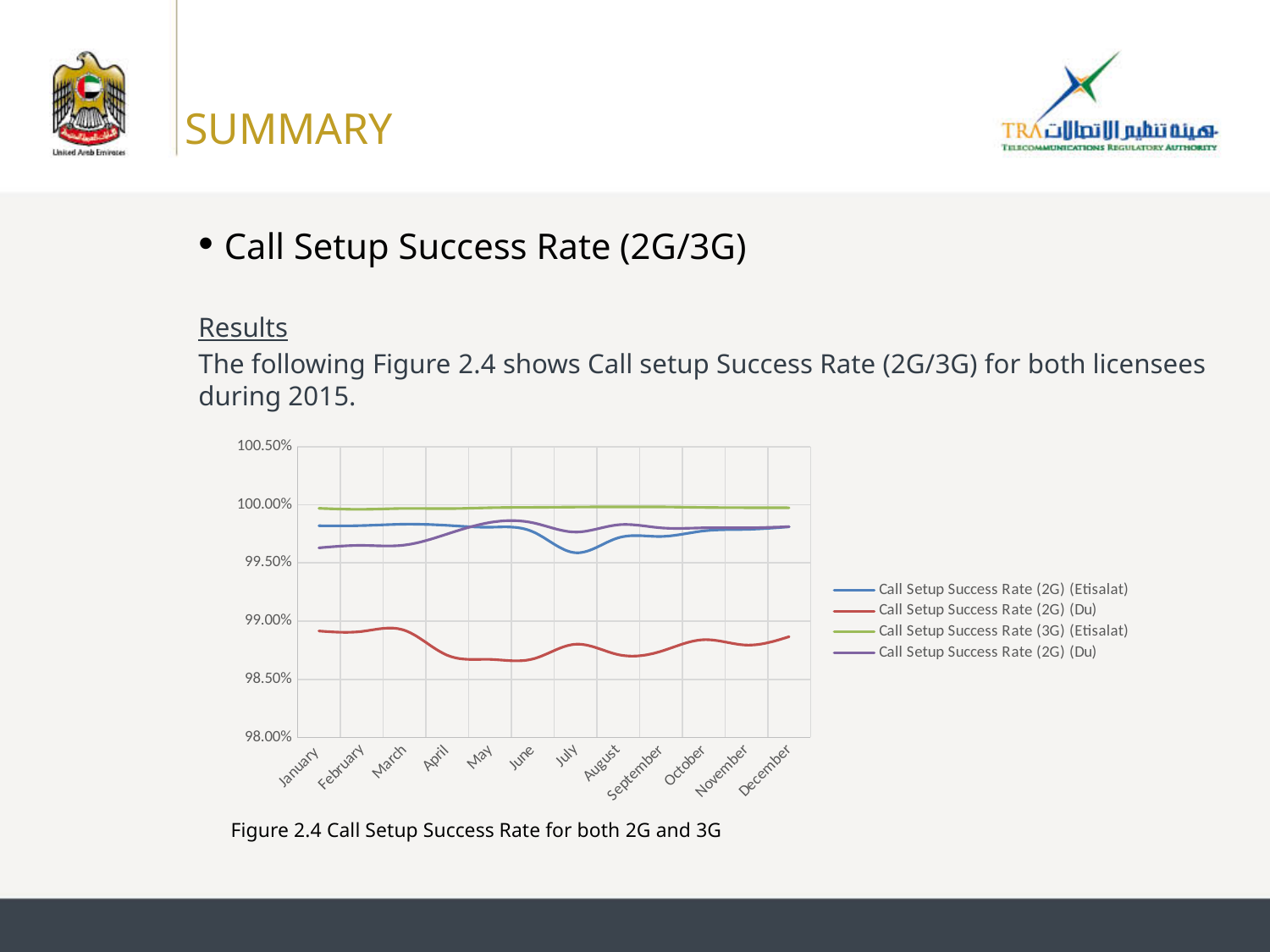
How many series does the chart's legend list? 4 Is the value of the red Call Setup Success Rate (2G) (Du) line in July greater or less than 99.00%? less Is the value of the Call Setup Success Rate (2G) (Etisalat) line in January greater or less than 99.50%? greater What kind of chart is shown on the slide? line chart What colour is the Call Setup Success Rate (3G) (Etisalat) line in the chart? green What is the caption printed below the chart? Figure 2.4 Call Setup Success Rate for both 2G and 3G Does the red Call Setup Success Rate (2G) (Du) line rise or fall from January to May? fall In January, which is higher: the Call Setup Success Rate (2G) (Etisalat) line or the red Call Setup Success Rate (2G) (Du) line? Call Setup Success Rate (2G) (Etisalat) How many months are plotted along the x axis of the chart? 12 Is the value of the Call Setup Success Rate (3G) (Etisalat) line in June greater or less than 99.50%? greater Which series is the lowest across all months in the chart? Call Setup Success Rate (2G) (Du) (red line) Which series stays highest across all months in the chart? Call Setup Success Rate (3G) (Etisalat)